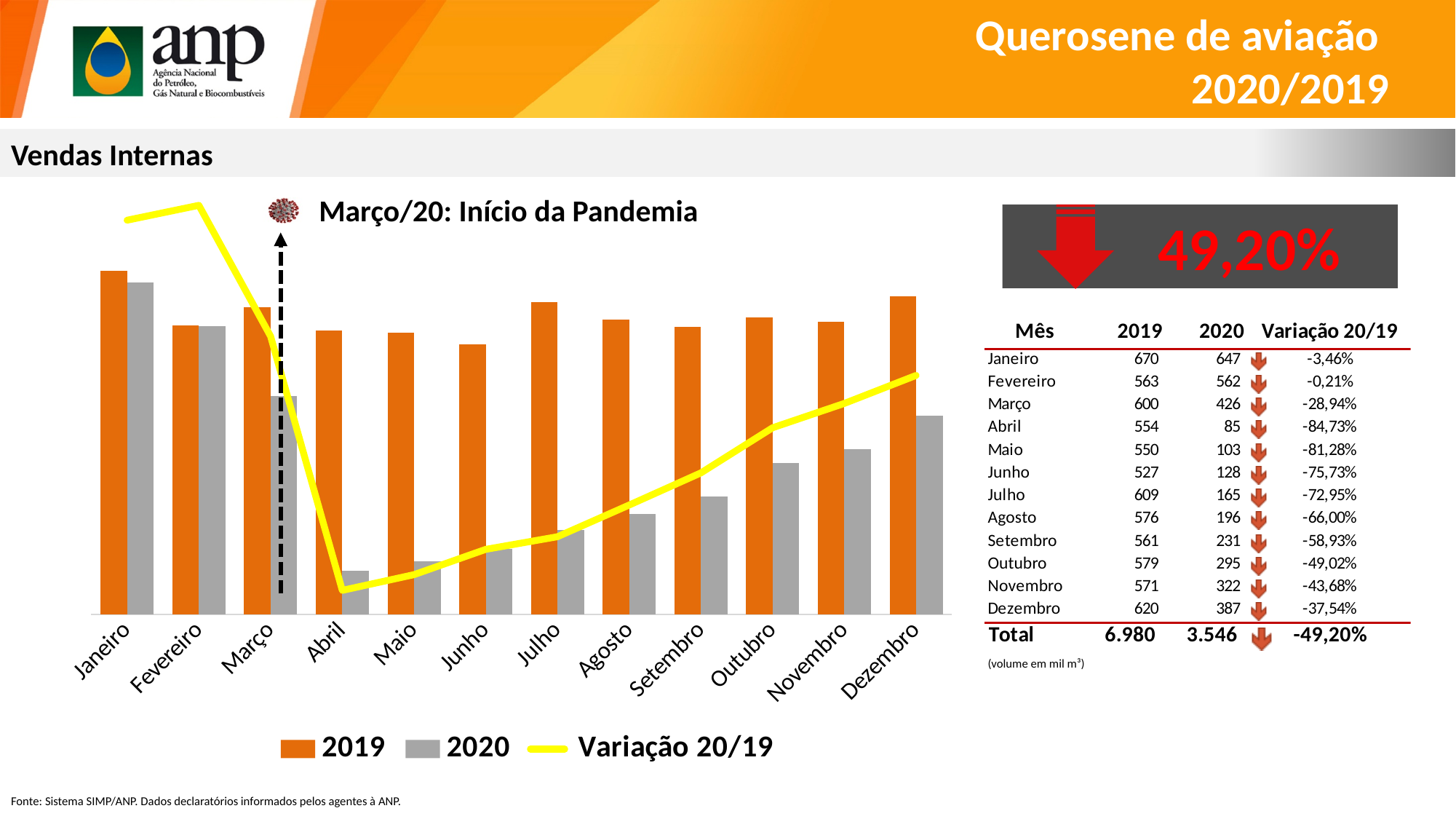
How many series does the chart legend list? 3 What is the 2019 value for Julho? 609 Which month has the lowest 2020 value? Abril What is the difference between the 2019 and 2020 values for Março? 174 What is the Variação 20/19 value for Abril? -84,73% Which is larger, the 2020 value for Dezembro or the 2020 value for Novembro? Dezembro What colour are the 2019 bars in the chart? orange Which month has the highest 2019 value? Janeiro What kind of chart is shown on the slide? bar chart with a line How many months are shown on the x axis of the chart? 12 What is the 2020 value for Abril? 85 Do the 2020 values rise or fall from Abril to Dezembro? rise